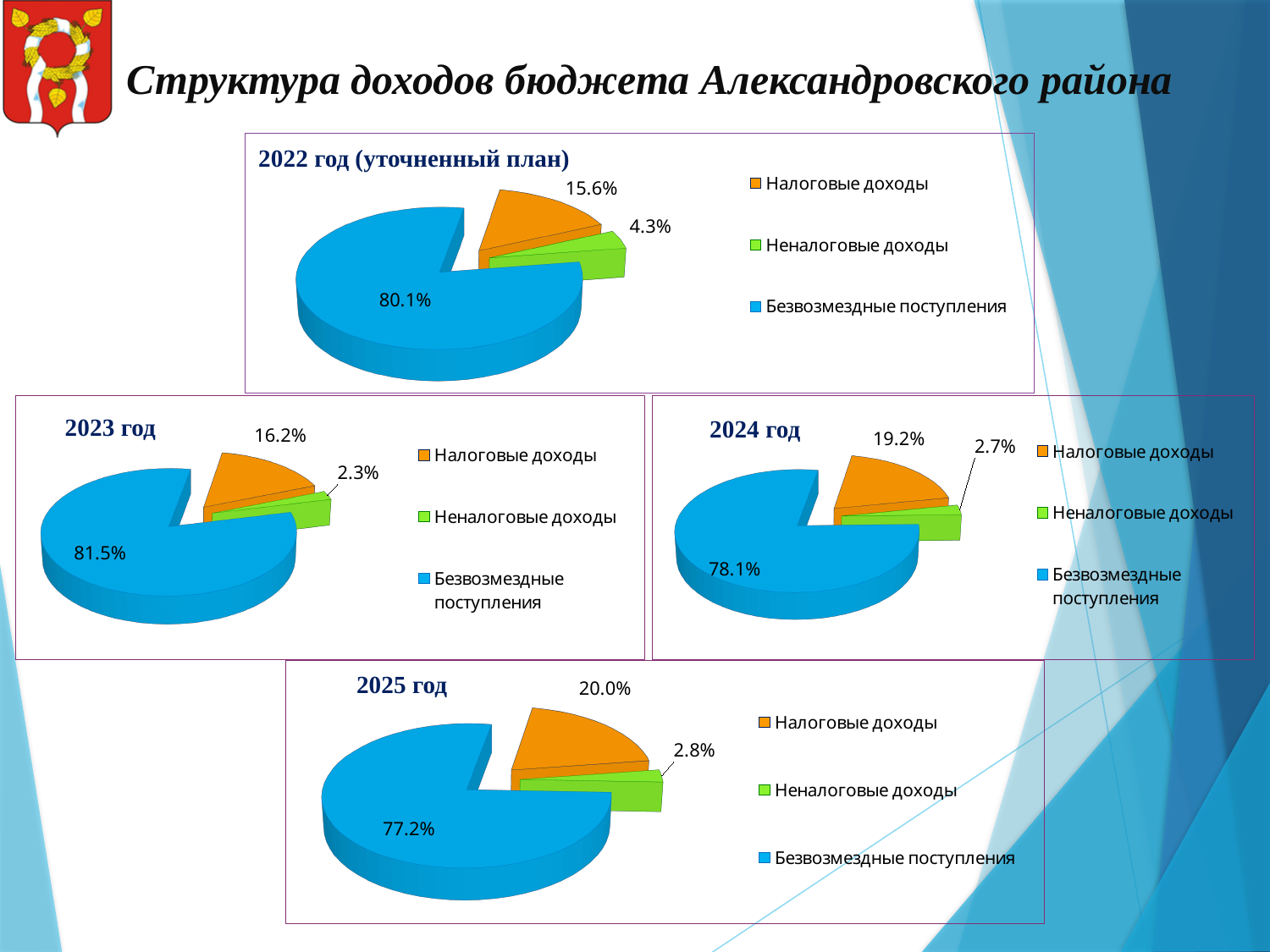
In the "2024 год" chart, what is the difference between the Безвозмездные поступления share and the Налоговые доходы share? 58.9% In the "2023 год" chart, what share is Безвозмездные поступления? 81.5% Which is larger: Налоговые доходы in the "2022 год (уточненный план)" chart or Налоговые доходы in the "2025 год" chart? 2025 год How many charts are shown on the slide? 4 In the "2022 год (уточненный план)" chart, what share is Налоговые доходы? 15.6% In the "2023 год" chart, which category has the smallest slice? Неналоговые доходы In the "2022 год (уточненный план)" chart, what share is Неналоговые доходы? 4.3% In the "2025 год" chart, what share is Неналоговые доходы? 2.8% In the "2025 год" chart, which category has the largest slice? Безвозмездные поступления What type of chart is used for "2023 год"? Pie chart How many slices does the "2024 год" pie chart have? 3 In the "2024 год" chart, what share is Налоговые доходы? 19.2%